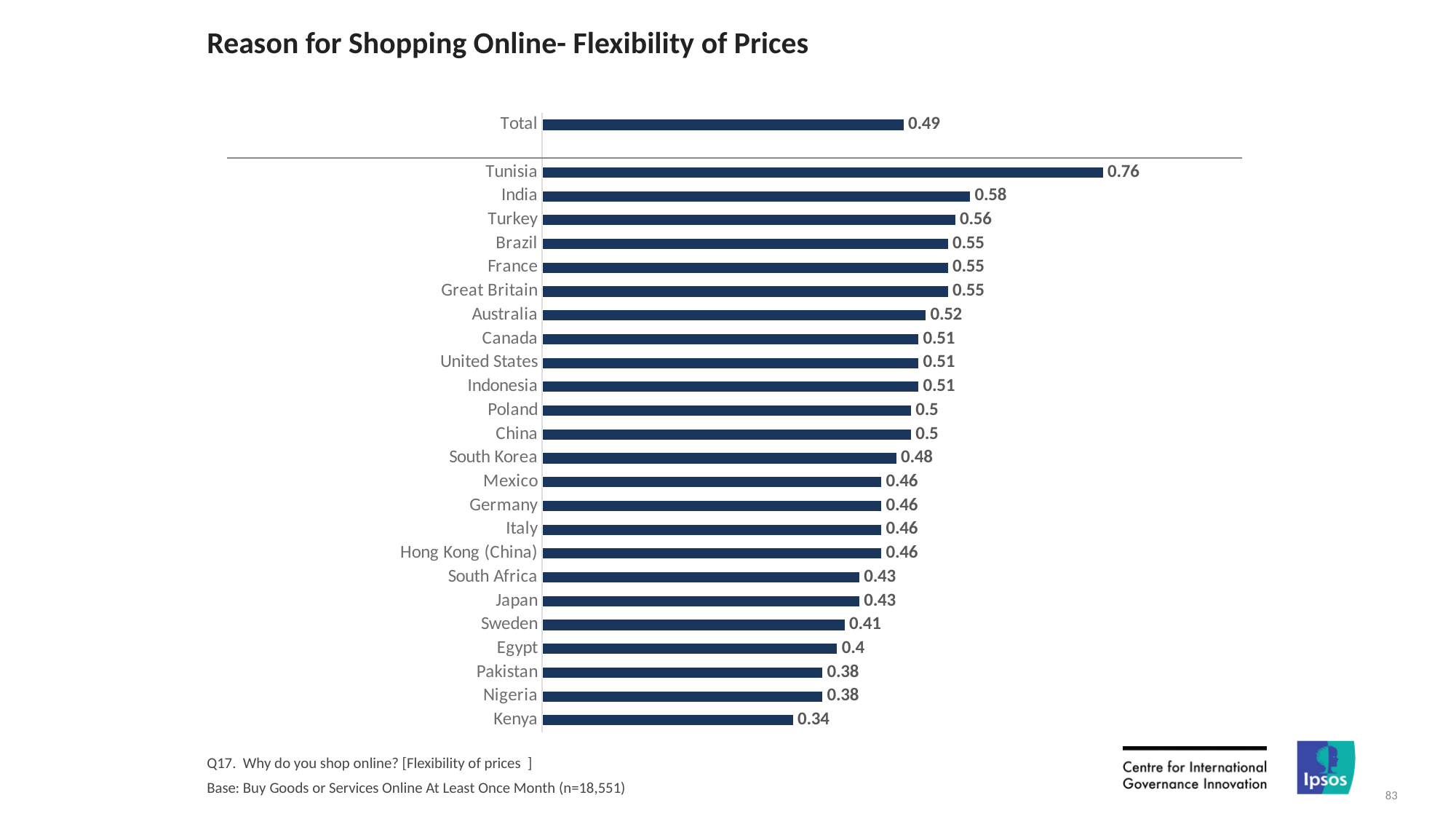
Which country has the lowest value? Kenya What is the value for Tunisia? 0.76 What is the value for Kenya? 0.34 Which has a larger value, Egypt or South Korea? South Korea Which has a larger value, Turkey or Sweden? Turkey Which country has the highest value? Tunisia What is the difference between the values for Total and Kenya? 0.15 What is the value for Total? 0.49 How many countries are listed below the Total bar? 23 What is the value for Australia? 0.52 What is the difference between the values for Tunisia and India? 0.18 What kind of chart is shown on the slide? Bar chart